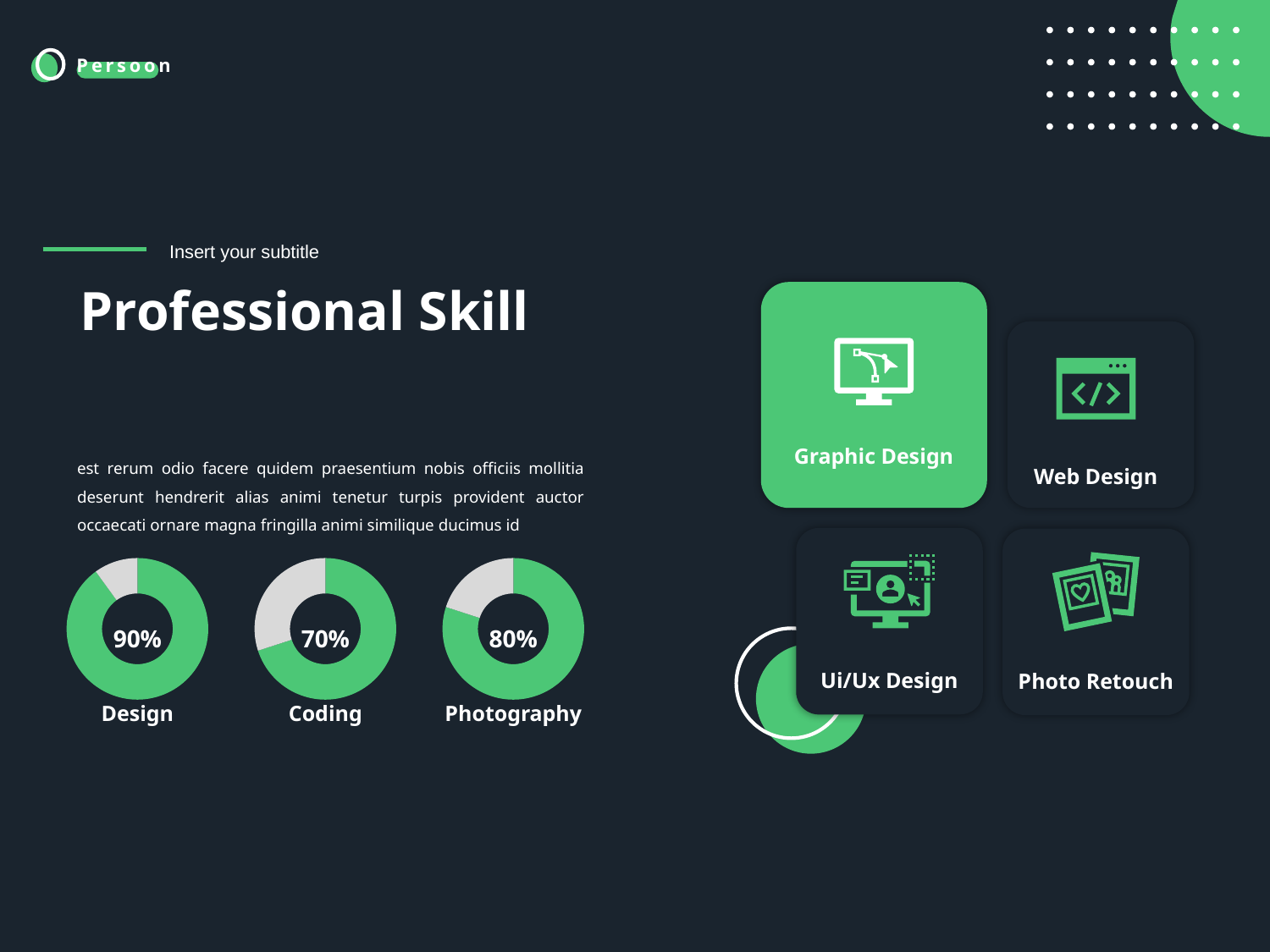
How many donut charts are shown on the slide? 3 What percentage is shown in the Design donut chart? 90% What colour is the filled portion of the donut charts? Green Which is larger, the Coding percentage or the Photography percentage? Photography What percentage is shown in the Coding donut chart? 70% What is the difference between the Design and Coding percentages? 20% What percentage is shown in the Photography donut chart? 80% What is the difference between the Photography and Coding percentages? 10% Which of the three donut charts shows the lowest percentage? Coding What is the title of the slide containing the donut charts? Professional Skill Which of the three donut charts shows the highest percentage? Design What type of chart is used to show the Design, Coding and Photography skills? Donut chart